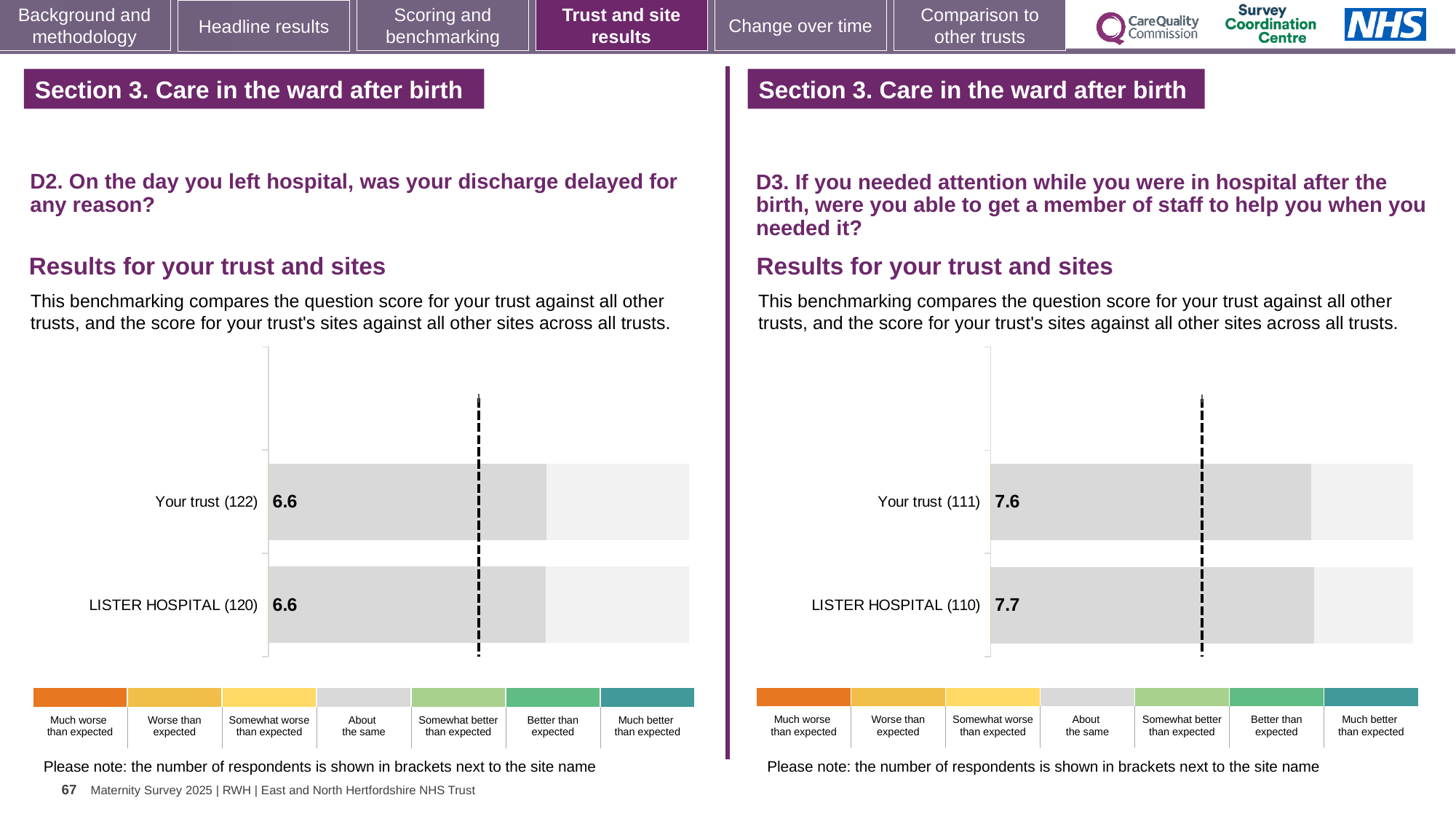
How many bars are plotted in the D2 chart on the left? 2 In the D3 chart on the right, what is the difference between the LISTER HOSPITAL score and the Your trust score? 0.1 In the D3 chart on the right, how many respondents are shown in brackets for Your trust? 111 How many bars are plotted in the D3 chart on the right? 2 In the D2 chart on the left, what is the score for Your trust (122)? 6.6 In the D2 chart on the left, what is the score for LISTER HOSPITAL (120)? 6.6 In the D3 chart on the right, what is the score for Your trust (111)? 7.6 What kind of chart is used for the D3 results on the right? Bar chart Is the Your trust score in the D3 chart on the right larger or smaller than the Your trust score in the D2 chart on the left? Larger In the D2 chart on the left, how many respondents are shown in brackets for LISTER HOSPITAL? 120 In the D2 chart on the left, what is the difference between the Your trust score and the LISTER HOSPITAL score? 0 In the D3 chart on the right, what is the score for LISTER HOSPITAL (110)? 7.7